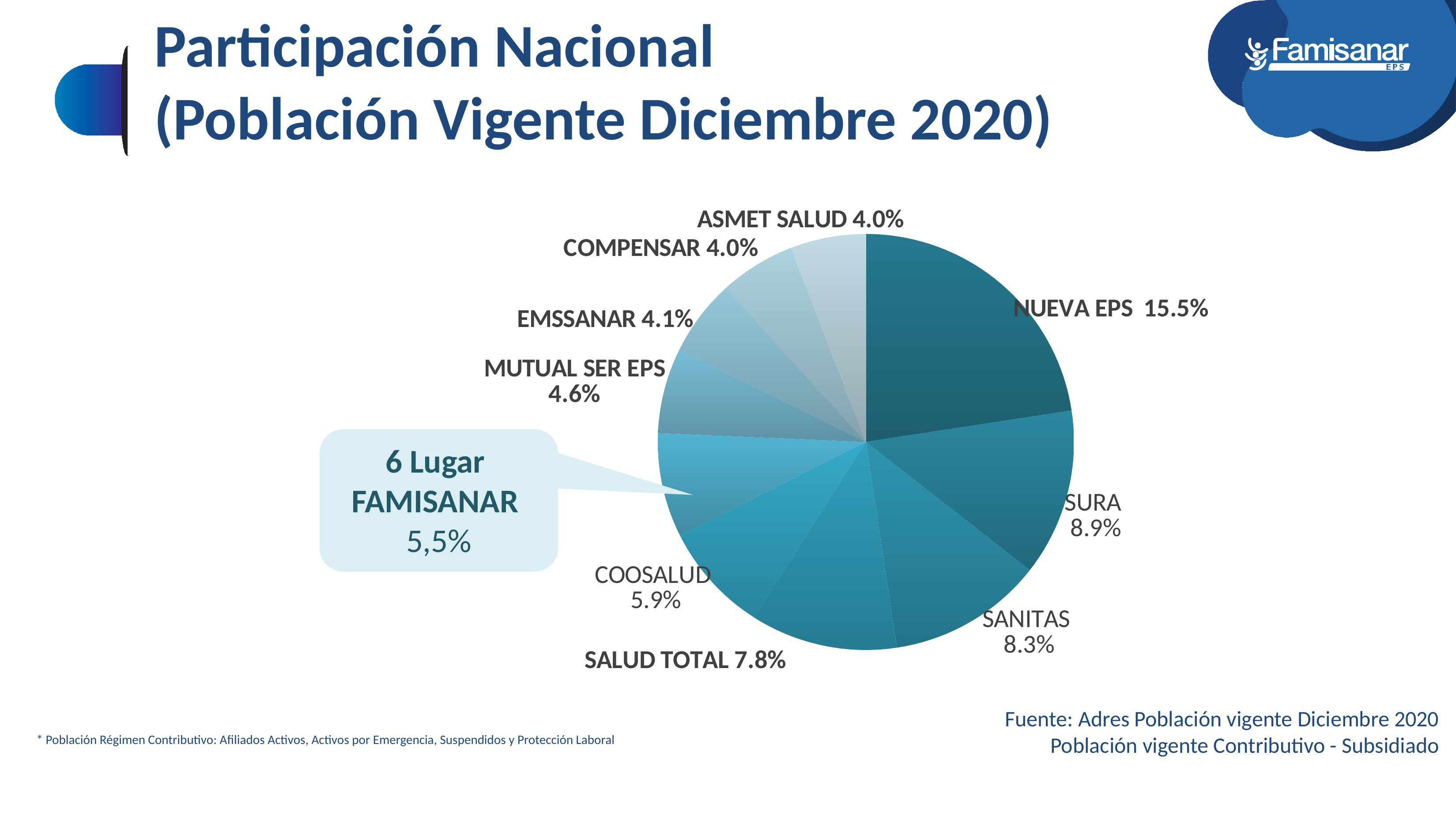
What share does SANITAS have in the pie chart? 8.3% What share does COOSALUD have in the pie chart? 5.9% What share does MUTUAL SER EPS have in the pie chart? 4.6% What share does SALUD TOTAL have in the pie chart? 7.8% Which has the larger share, SURA or SANITAS? SURA What share does FAMISANAR have according to the callout on the slide? 5,5% What share does NUEVA EPS have in the pie chart? 15.5% In what position (lugar) does the callout say FAMISANAR ranks? 6 What kind of chart is shown on the slide? Pie chart What is the difference between the shares of NUEVA EPS and SURA? 6.6% What share does EMSSANAR have in the pie chart? 4.1% What share does SURA have in the pie chart? 8.9%